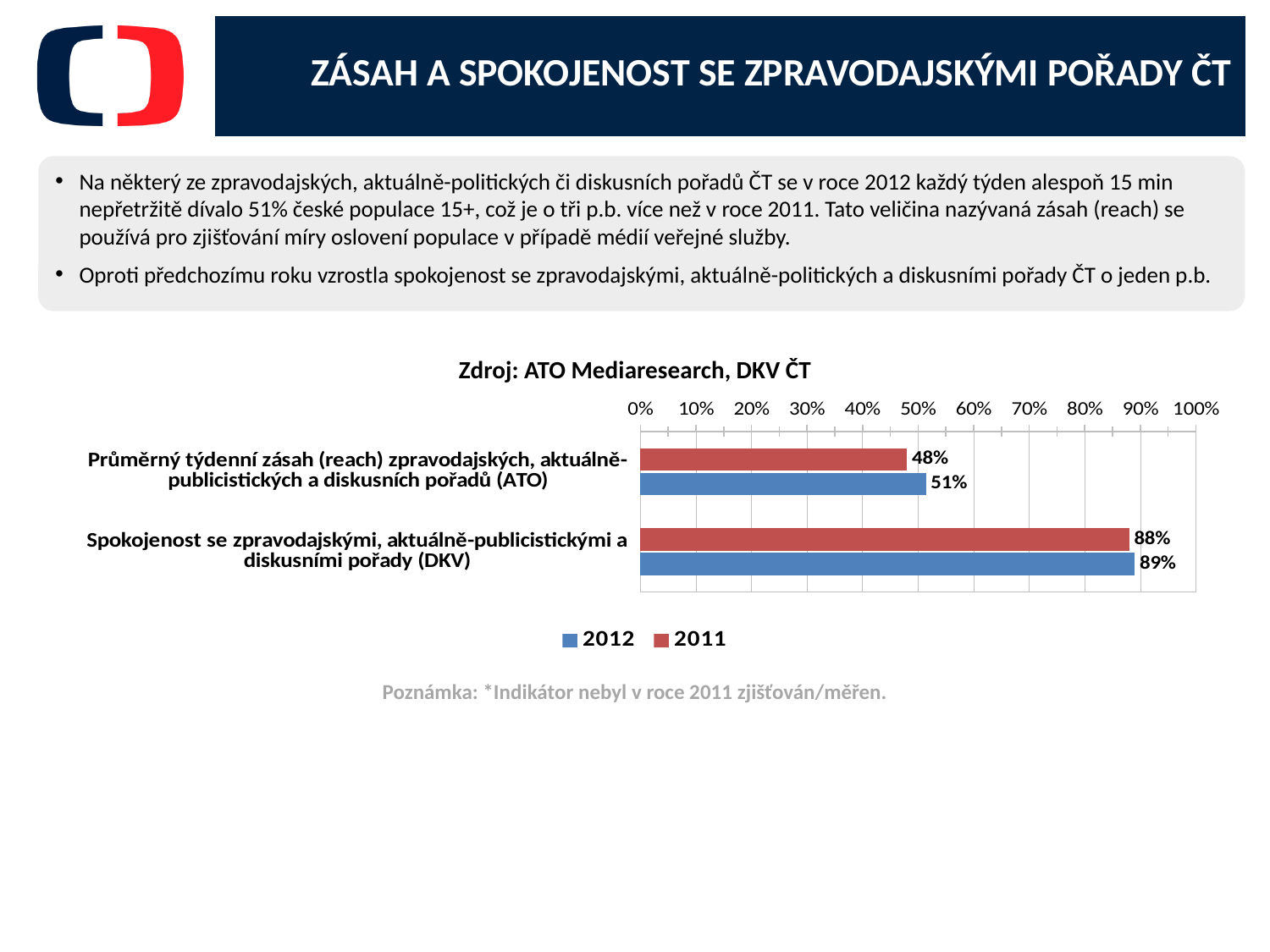
Which is larger for 'Průměrný týdenní zásah (reach)' (ATO): the 2012 value or the 2011 value? 2012 Which category has the highest 2012 value? Spokojenost se zpravodajskými, aktuálně-publicistickými a diskusními pořady (DKV) What is the 2012 value for 'Spokojenost se zpravodajskými, aktuálně-publicistickými a diskusními pořady (DKV)'? 89% What is the 2012 value for 'Průměrný týdenní zásah (reach) zpravodajských, aktuálně-publicistických a diskusních pořadů (ATO)'? 51% Which category has the lowest 2011 value? Průměrný týdenní zásah (reach) zpravodajských, aktuálně-publicistických a diskusních pořadů (ATO) What is the 2011 value for 'Spokojenost se zpravodajskými, aktuálně-publicistickými a diskusními pořady (DKV)'? 88% How many series does the legend list? 2 How many categories are shown on the chart? 2 What kind of chart is shown on the slide? Bar chart What is the difference between the 2012 and 2011 values for 'Průměrný týdenní zásah (reach)' (ATO)? 3 percentage points What is the 2011 value for 'Průměrný týdenní zásah (reach) zpravodajských, aktuálně-publicistických a diskusních pořadů (ATO)'? 48% What is the difference between the 2012 and 2011 values for 'Spokojenost' (DKV)? 1 percentage point